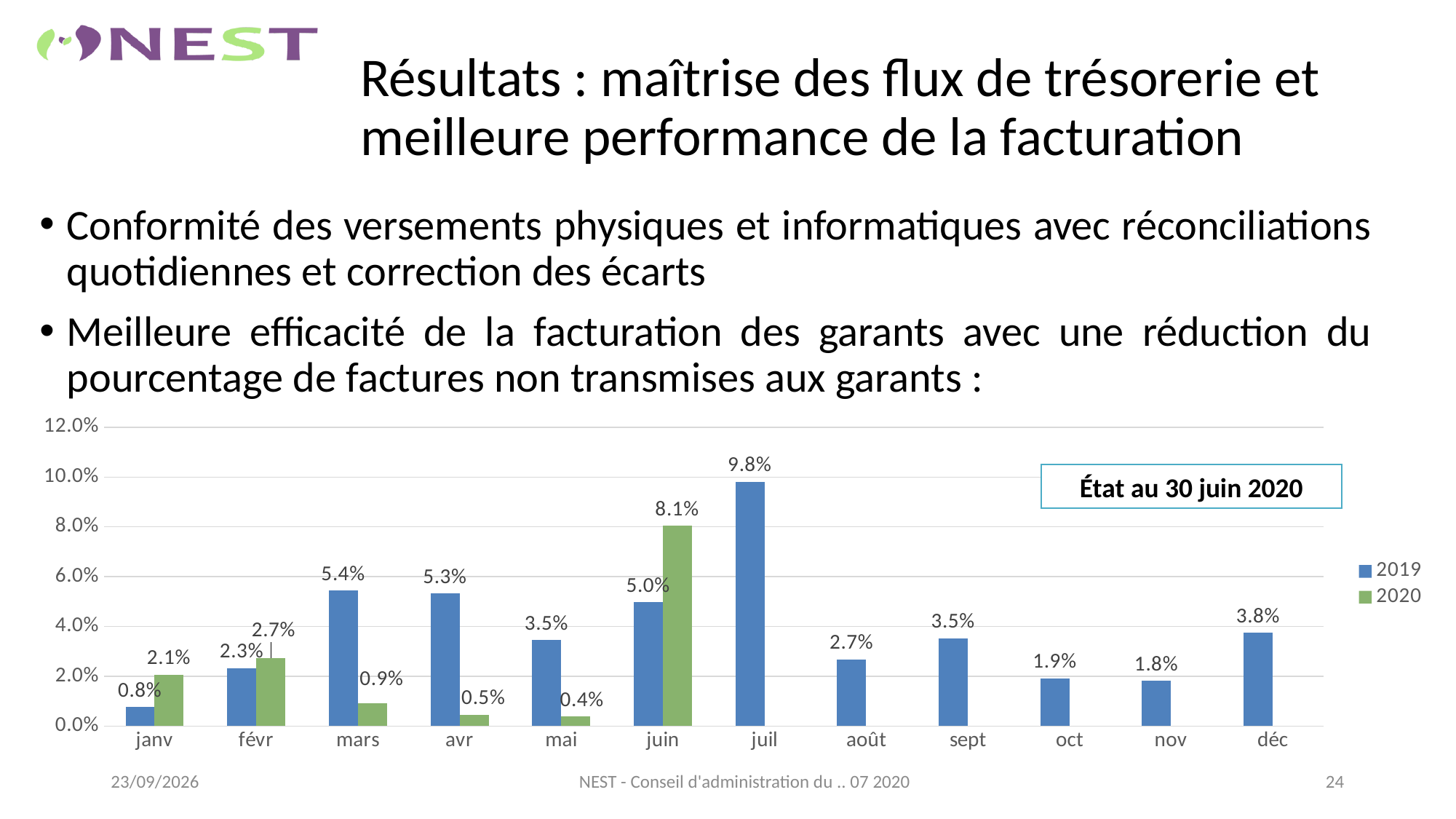
How many series does the legend list? 2 How many months have a value plotted for the 2020 series? 6 What text appears in the box inside the chart area? État au 30 juin 2020 Do the 2020 values rise or fall from févr to mai? fall What is the value for 2020 in mai? 0.4% Which month has the lowest value for the 2019 series? janv Which is larger in janv, the 2019 value or the 2020 value? 2020 What is the value for 2020 in juin? 8.1% What is the difference between the 2019 and 2020 values in mars? 4.5% What is the value for 2019 in juil? 9.8% What kind of chart is shown on the slide? bar chart Which month has the highest value for the 2019 series? juil